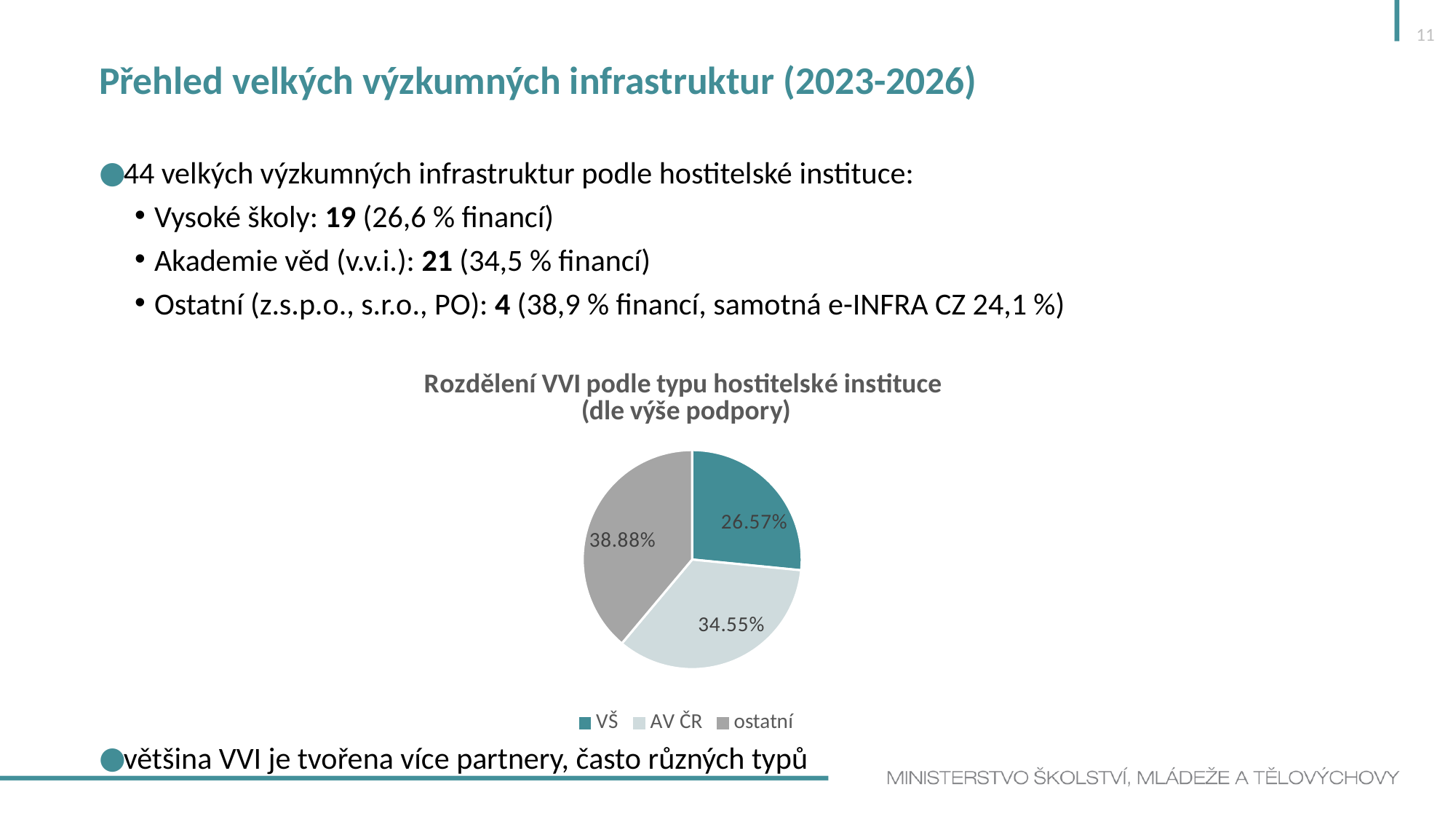
What share of the pie does VŠ have? 26.57% What is the title of the chart? Rozdělení VVI podle typu hostitelské instituce (dle výše podpory) What share of the pie does AV ČR have? 34.55% How many slices does the pie chart have? 3 Which is larger, the slice for AV ČR or the slice for VŠ? AV ČR How many entries does the legend list? 3 What kind of chart is shown on the slide? pie chart Which category has the largest slice of the pie? ostatní What share of the pie does ostatní have? 38.88% What is the difference in percentage points between the ostatní slice and the VŠ slice? 12.31 What is the difference in percentage points between the AV ČR slice and the VŠ slice? 7.98 Which category has the smallest slice of the pie? VŠ